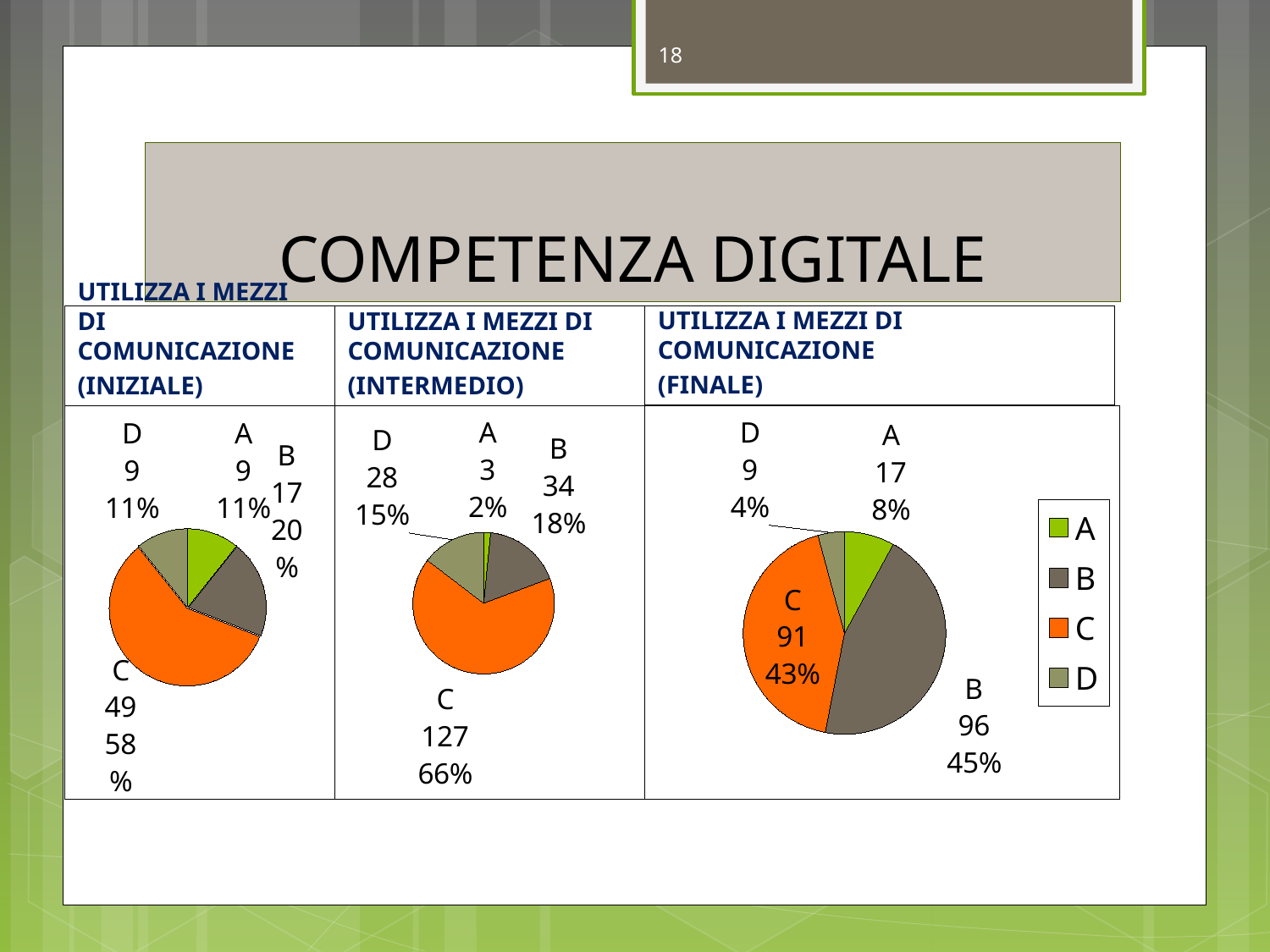
In the (INTERMEDIO) pie chart, what share of the pie does category C have? 66% In the (INIZIALE) pie chart, what is the value for category C? 49 In the (FINALE) pie chart, what is the value for category A? 17 In the (INIZIALE) pie chart, which is larger, the value for B or the value for D? B In the (FINALE) pie chart, which category has the largest value? B In the (INTERMEDIO) pie chart, what is the difference between the values for B and D? 6 In the (INIZIALE) pie chart, what share of the pie does category B have? 20% What kind of chart is used for the (FINALE) data? Pie chart How many categories does the legend on the slide list? 4 In the (INTERMEDIO) pie chart, what is the value for category D? 28 In the (INTERMEDIO) pie chart, which category has the smallest value? A In the (FINALE) pie chart, what is the difference between the values for B and C? 5